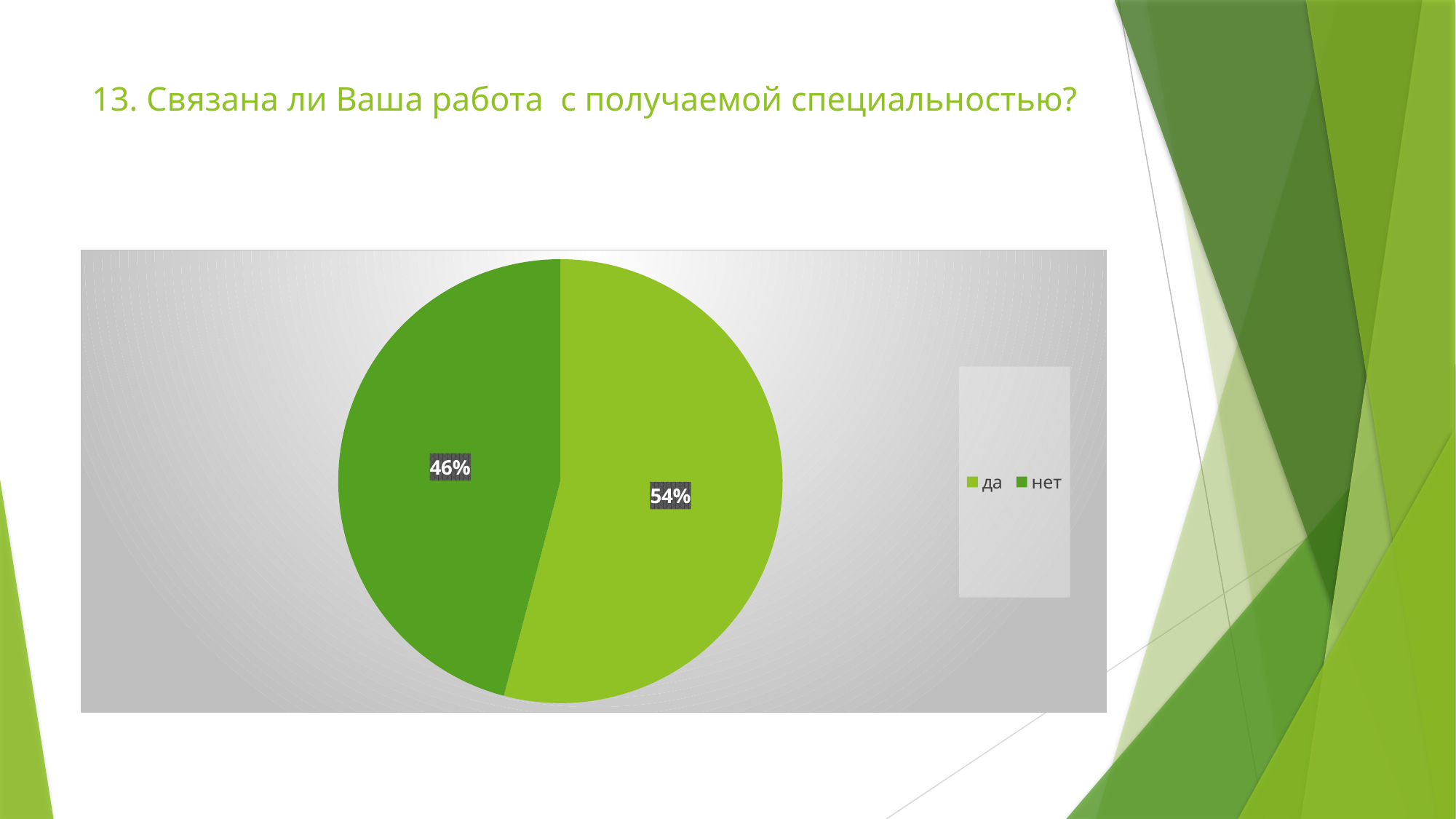
What kind of chart is shown on the slide? pie chart Which slice is the smallest? нет Is the share for "нет" greater or less than 50%? less What is the difference in percentage points between the "да" and "нет" slices? 8 Which legend entry is shown in the darker green colour? нет What is the title of the slide above the chart? 13. Связана ли Ваша работа с получаемой специальностью? How many slices does the pie chart have? 2 Which slice is the largest? да What share of the pie is labelled "да"? 54% How many entries does the legend list? 2 What share of the pie is labelled "нет"? 46% Which slice is larger, "да" or "нет"? да